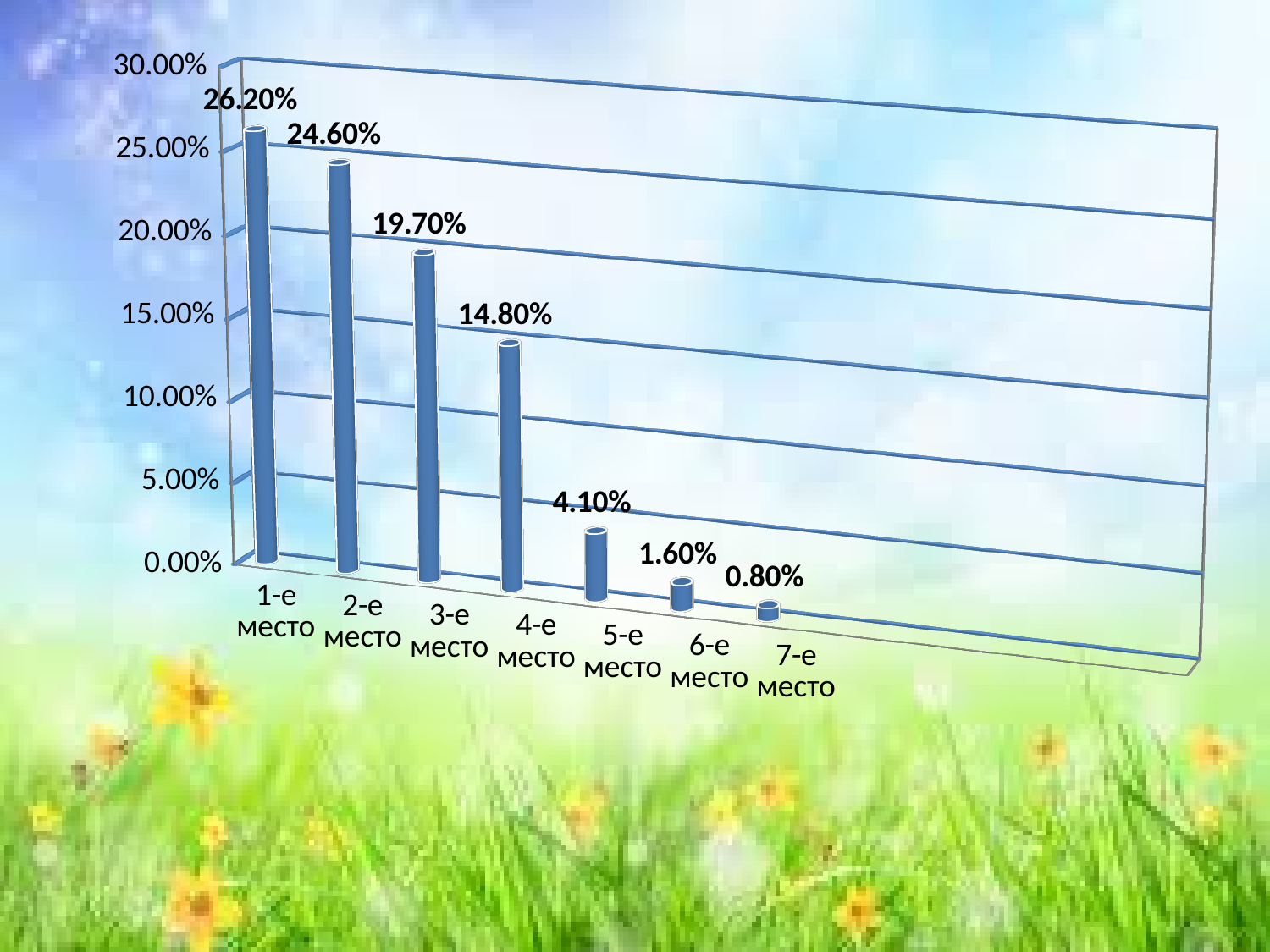
Do the values rise or fall from 1-е место to 7-е место? fall What is the value for 4-е место? 14.80% Which category has the highest value? 1-е место What kind of chart is shown on the slide? bar chart Which is larger, the value for 5-е место or the value for 6-е место? 5-е место What is the difference between the values for 3-е место and 4-е место? 4.90% What is the value for 7-е место? 0.80% Is the value for 3-е место greater or less than 20.00%? less What is the difference between the values for 1-е место and 2-е место? 1.60% How many categories are shown on the x axis? 7 Which category has the lowest value? 7-е место What is the value for 1-е место? 26.20%